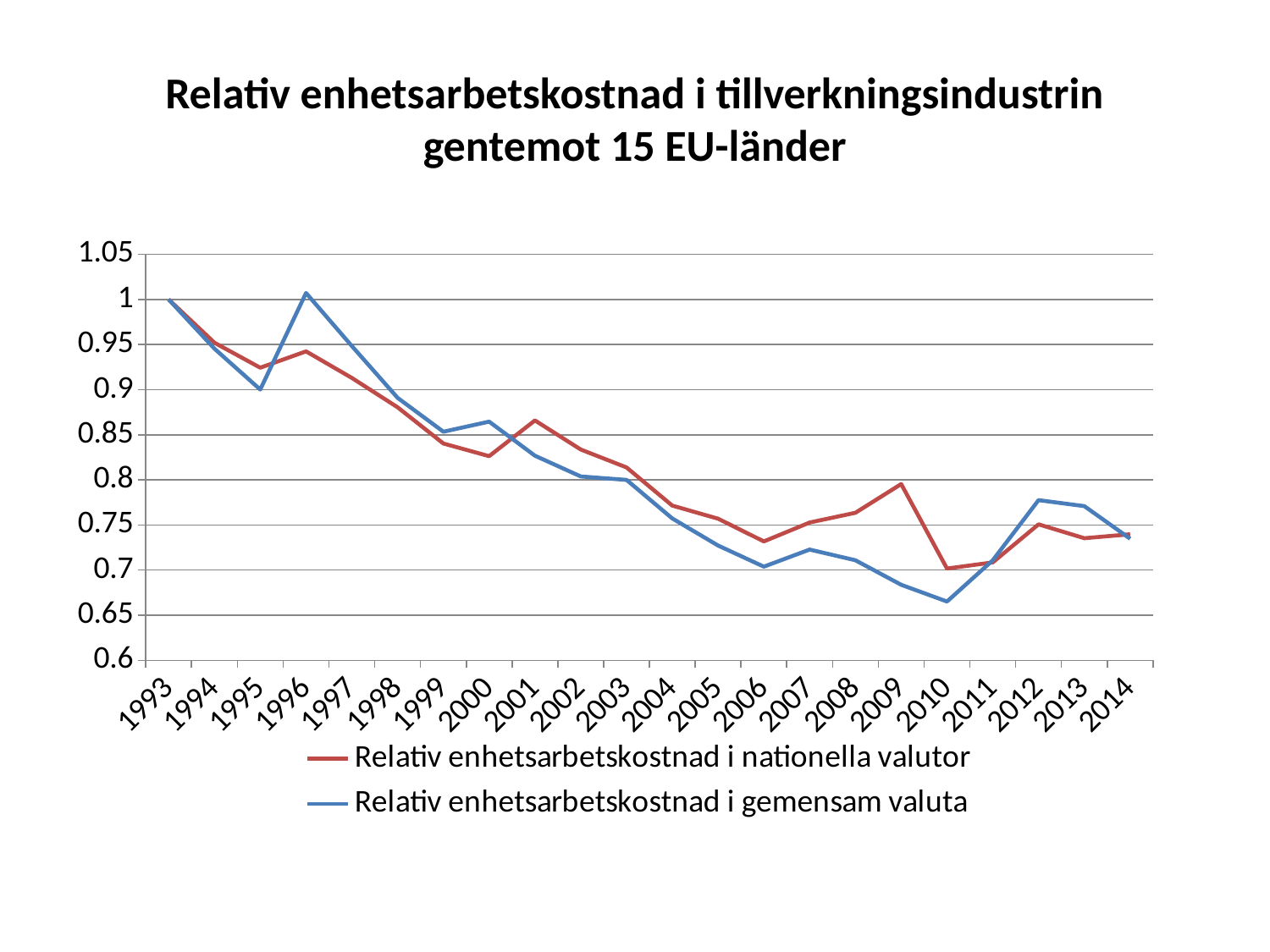
In which year is 'Relativ enhetsarbetskostnad i nationella valutor' highest? 1993 What is the value of 'Relativ enhetsarbetskostnad i nationella valutor' in 1993? 1 Do the values of 'Relativ enhetsarbetskostnad i gemensam valuta' generally rise or fall from 1993 to 2014? fall In which year is 'Relativ enhetsarbetskostnad i gemensam valuta' lowest? 2010 What is the value of 'Relativ enhetsarbetskostnad i gemensam valuta' in 1993? 1 How many years are plotted along the x axis? 22 In 1996, which series has the larger value: 'Relativ enhetsarbetskostnad i nationella valutor' or 'Relativ enhetsarbetskostnad i gemensam valuta'? Relativ enhetsarbetskostnad i gemensam valuta How many series does the legend list? 2 What kind of chart is shown on the slide? line chart Is the value for 'Relativ enhetsarbetskostnad i nationella valutor' in 2009 greater or less than 0.75? greater Is the value for 'Relativ enhetsarbetskostnad i gemensam valuta' in 2010 greater or less than 0.7? less Which colour is used for the 'Relativ enhetsarbetskostnad i nationella valutor' line? red